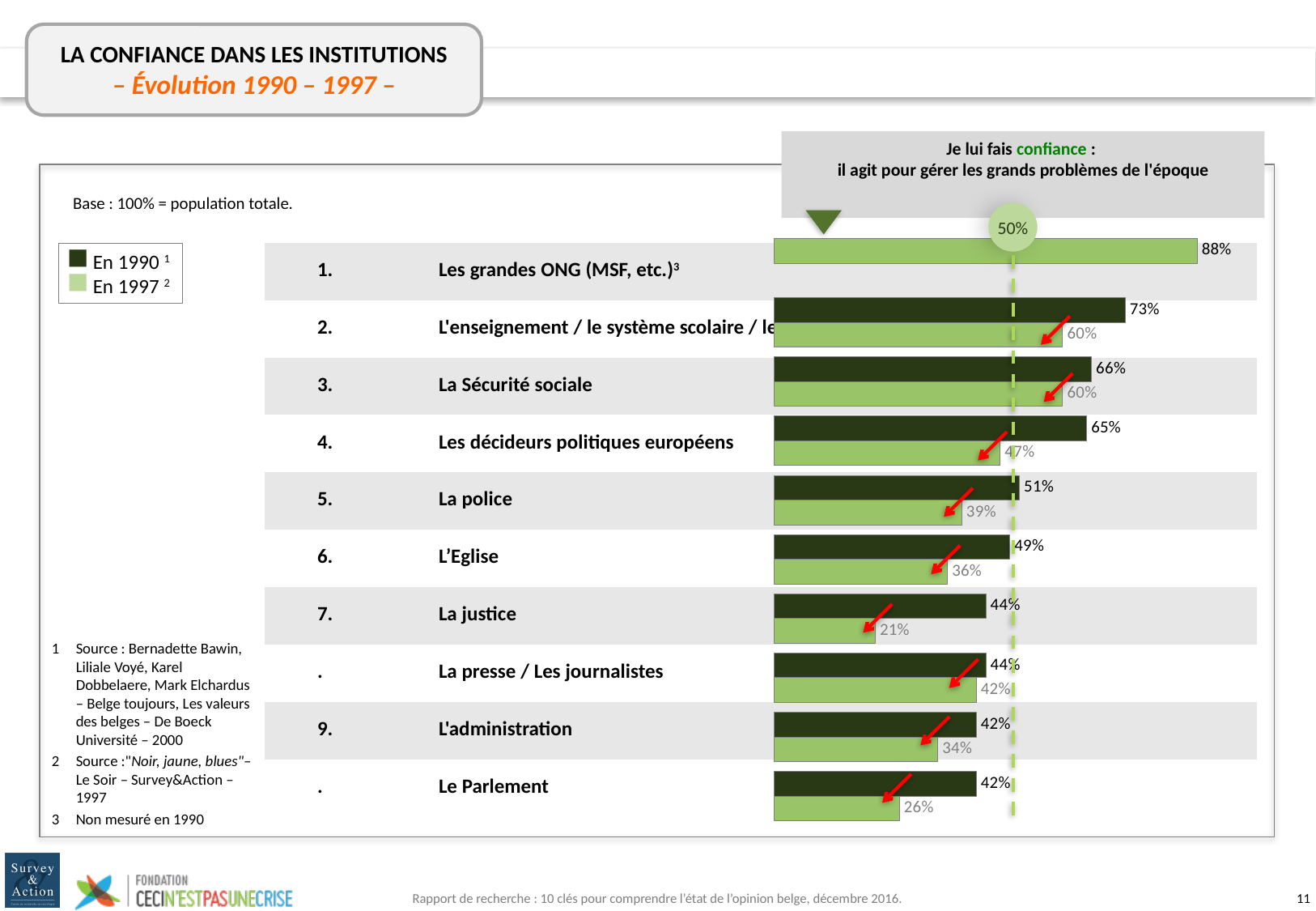
What is the difference between the 1990 and 1997 values for La justice? 23% Which is larger: the 1997 value for La police or the 1997 value for L'Eglise? La police What kind of chart is shown on the slide? bar chart How many series does the legend list? 2 Which institution is marked as not measured in 1990? Les grandes ONG (MSF, etc.) What is the value for L'enseignement / le système scolaire in 1990? 73% What is the value for Les grandes ONG (MSF, etc.) in 1997? 88% How many institutions are listed in the chart? 10 What is the value for La justice in 1997? 21% Which institution has the highest value in 1997? Les grandes ONG (MSF, etc.) Which institution has the lowest value in 1997? La justice What is the value for Le Parlement in 1990? 42%